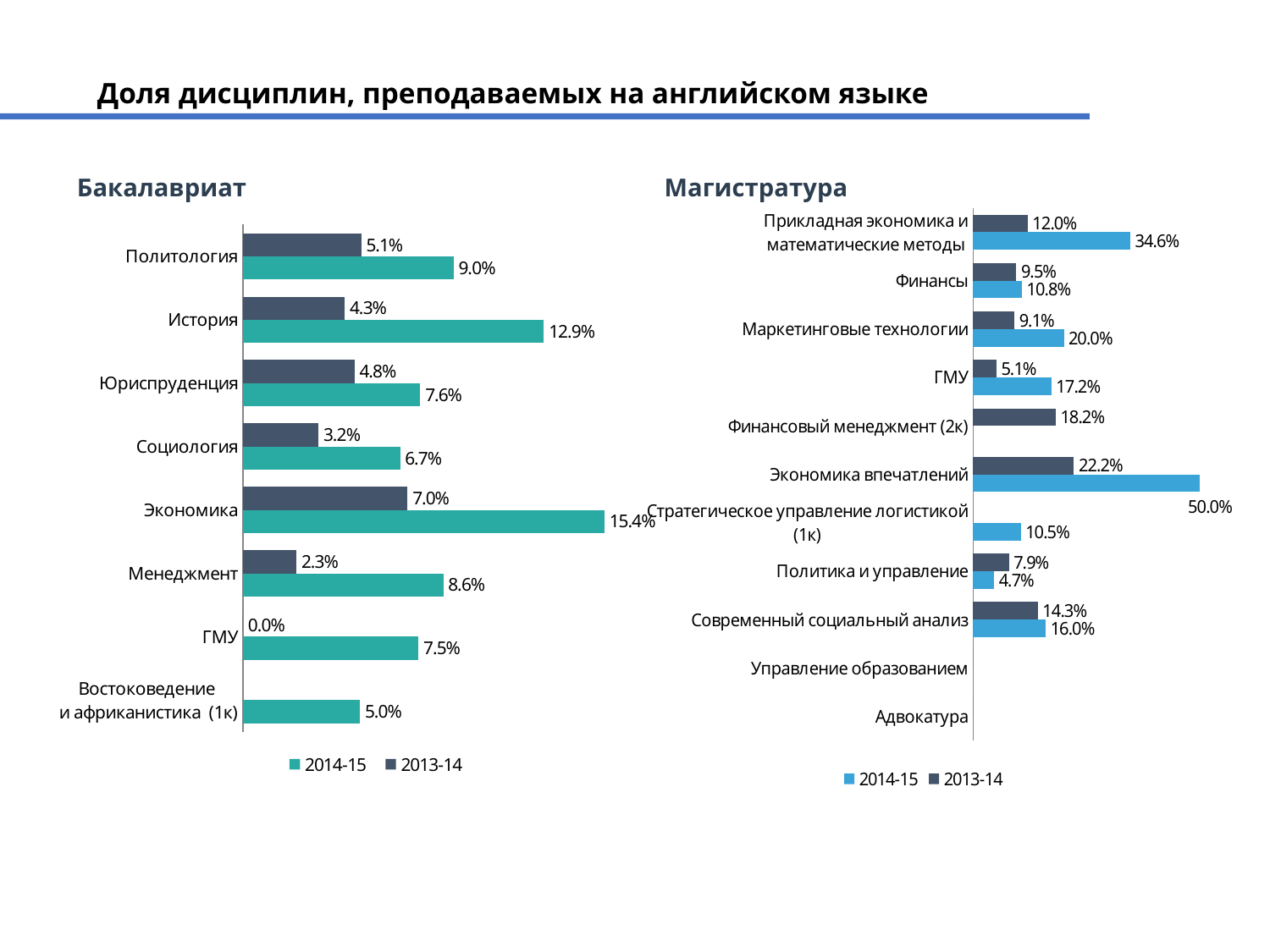
In the Магистратура chart, which is larger for Политика и управление: the 2014-15 value or the 2013-14 value? 2013-14 In the Бакалавриат chart, which category has the highest 2014-15 value? Экономика In the Бакалавриат chart, what is the 2014-15 value for История? 12.9% In the Магистратура chart, what is the difference between the 2014-15 and 2013-14 values for Маркетинговые технологии? 10.9% In the Магистратура chart, what is the 2014-15 value for Прикладная экономика и математические методы? 34.6% In the Магистратура chart, which category has the highest 2014-15 value? Экономика впечатлений What type of chart is the Бакалавриат chart? Bar chart In the Бакалавриат chart, what is the 2013-14 value for Менеджмент? 2.3% In the Бакалавриат chart, how many categories are shown? 8 In the Бакалавриат chart, what is the difference between the 2014-15 and 2013-14 values for Экономика? 8.4% In the Бакалавриат chart, what is the 2013-14 value for ГМУ? 0.0% How many series does the legend of the Магистратура chart list? 2